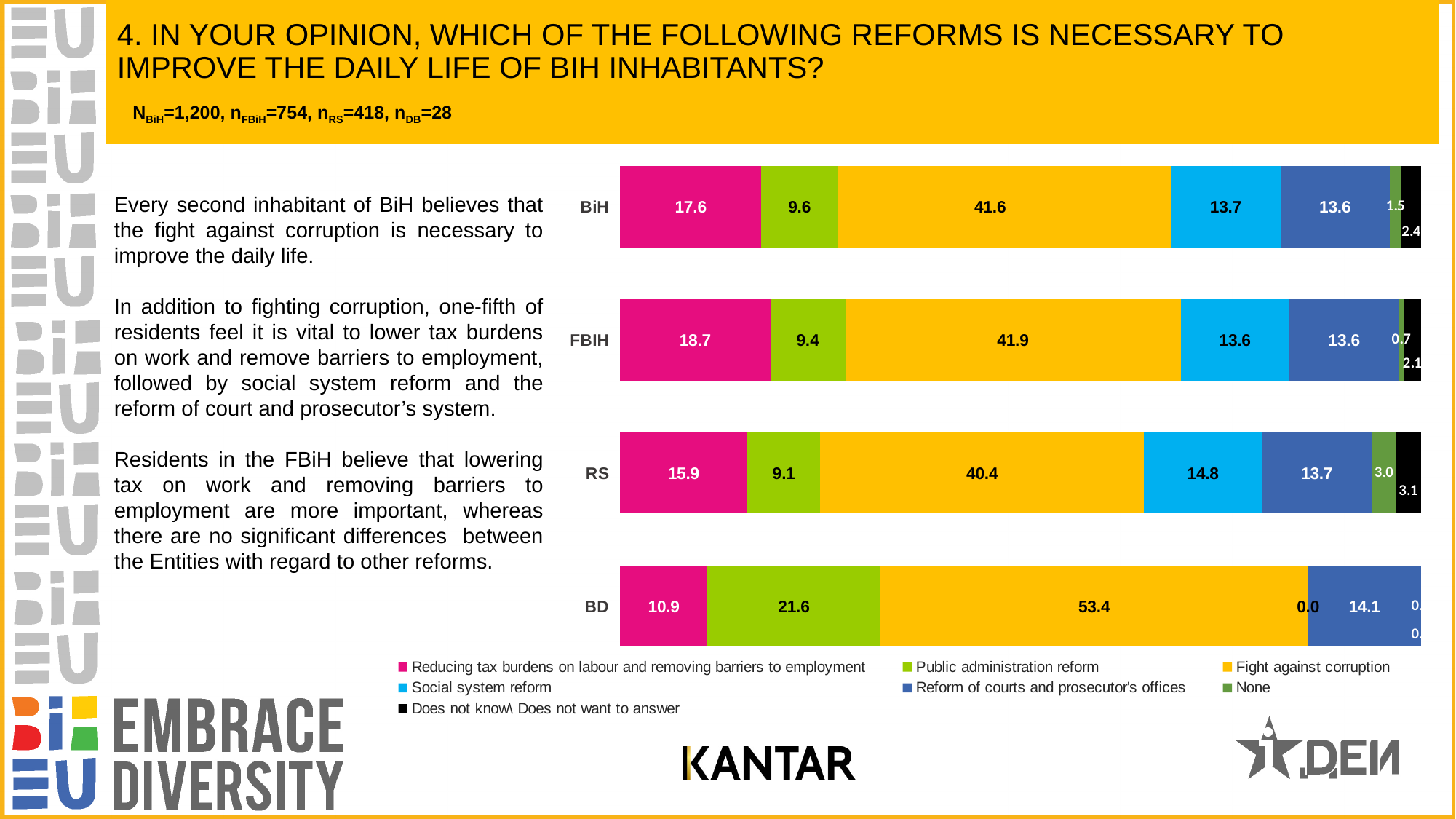
What is the value for Reducing tax burdens on labour and removing barriers to employment in the FBIH bar? 18.7 How many categories (bars) does the chart show? 4 What is the value for Public administration reform in the BD bar? 21.6 What is the value for Fight against corruption in the BiH bar? 41.6 Which is larger: the Reducing tax burdens value for FBIH or for RS? FBIH Which category has the highest value for Fight against corruption? BD What is the total of the BiH stacked bar? 100.0 What kind of chart is shown on the slide? Stacked bar chart What is the difference between the Fight against corruption values for BD and RS? 13.0 How many series does the legend list? 7 Which category has the lowest value for Reducing tax burdens on labour and removing barriers to employment? BD What is the value for Social system reform in the RS bar? 14.8